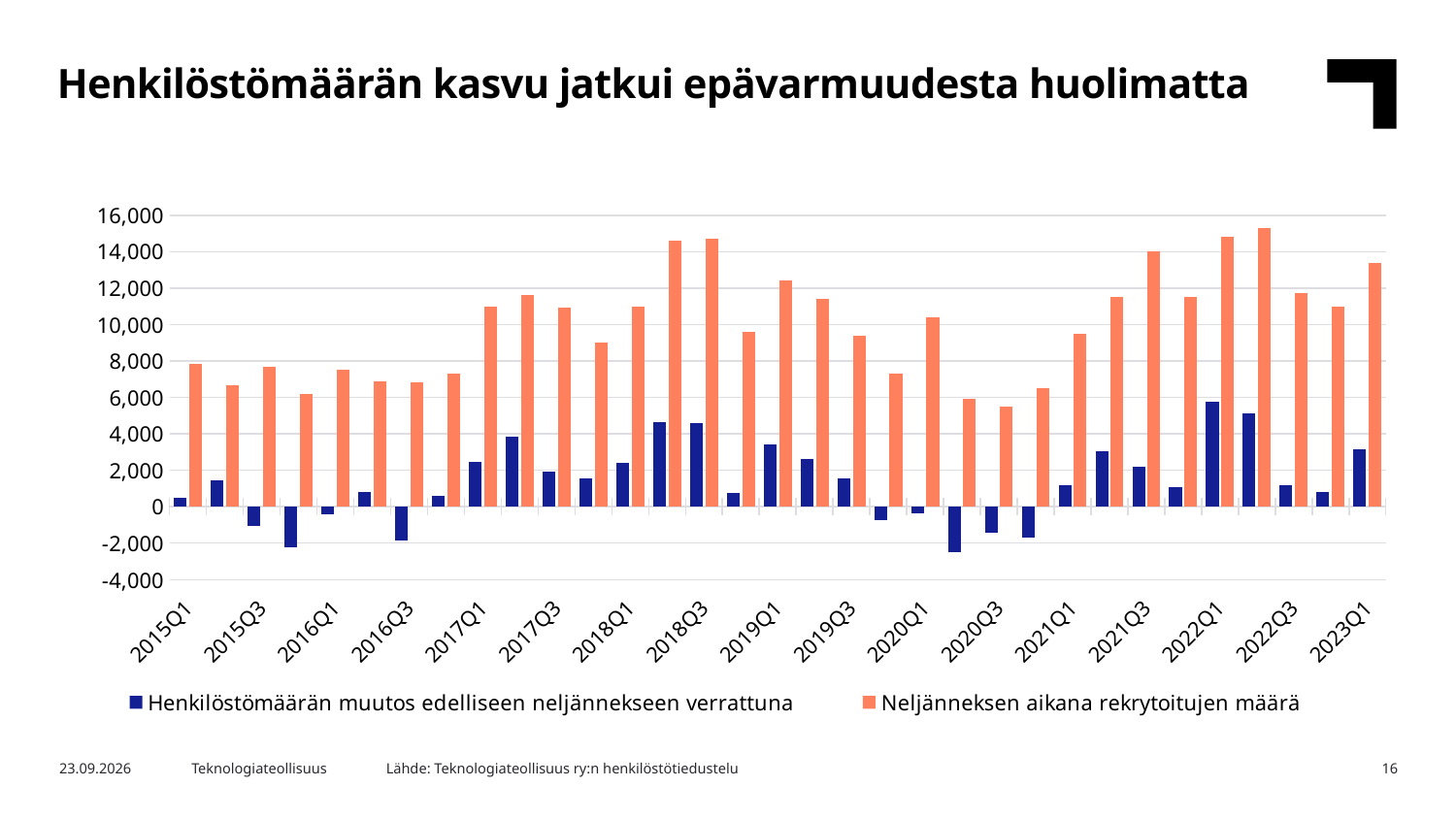
How many quarters (categories) are plotted on the x axis, from 2015Q1 to 2023Q1? 33 How many series does the legend list? 2 Which is larger: the 'Neljänneksen aikana rekrytoitujen määrä' value for 2022Q3 or for 2015Q1? 2022Q3 Is the value of 'Neljänneksen aikana rekrytoitujen määrä' for 2022Q3 greater or less than 14,000? less What is the title of the slide? Henkilöstömäärän kasvu jatkui epävarmuudesta huolimatta Is the value of 'Henkilöstömäärän muutos edelliseen neljännekseen verrattuna' for 2022Q1 greater or less than 4,000? greater Does the 'Neljänneksen aikana rekrytoitujen määrä' series rise or fall from 2020Q3 to 2022Q3? rise What kind of chart is shown on the slide? bar chart Which is larger: the 'Neljänneksen aikana rekrytoitujen määrä' value for 2020Q3 or for 2021Q3? 2021Q3 Which colour represents 'Neljänneksen aikana rekrytoitujen määrä' in the legend? orange Is the value of 'Neljänneksen aikana rekrytoitujen määrä' for 2023Q1 greater or less than 12,000? greater